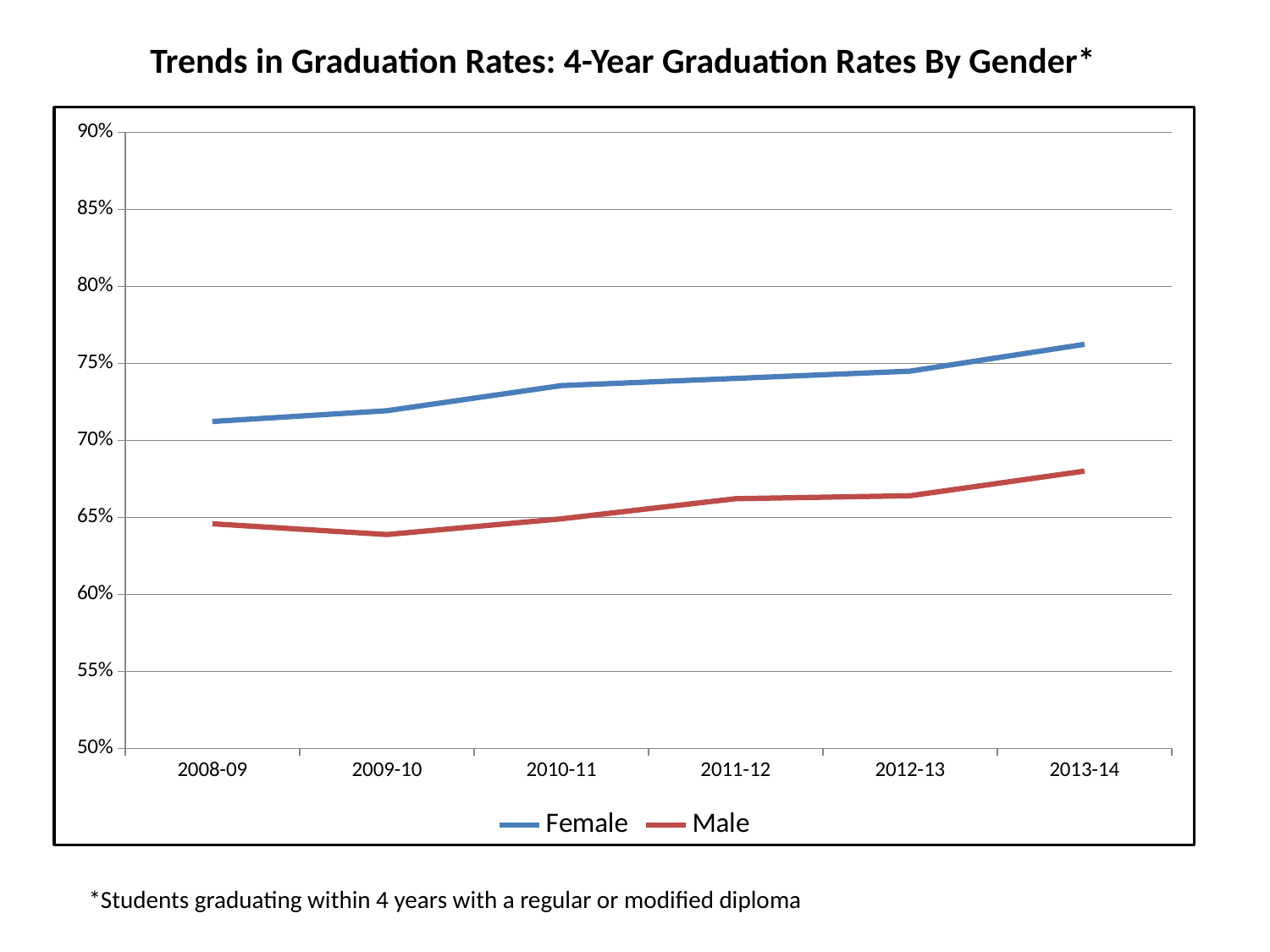
In 2013-14, which is larger, the Female rate or the Male rate? Female Does the Female graduation rate rise or fall from 2008-09 to 2013-14? rise What kind of chart is shown on the slide? line chart What is the title of the chart? Trends in Graduation Rates: 4-Year Graduation Rates By Gender* In which year is the Female graduation rate highest? 2013-14 How many school years are plotted along the x axis? 6 Which series is shown in blue? Female Is the Female value for 2013-14 greater or less than 75%? greater In which year is the Female graduation rate lowest? 2008-09 In which year is the Male graduation rate lowest? 2009-10 Is the Male value for 2009-10 greater or less than 65%? less How many series does the legend list? 2